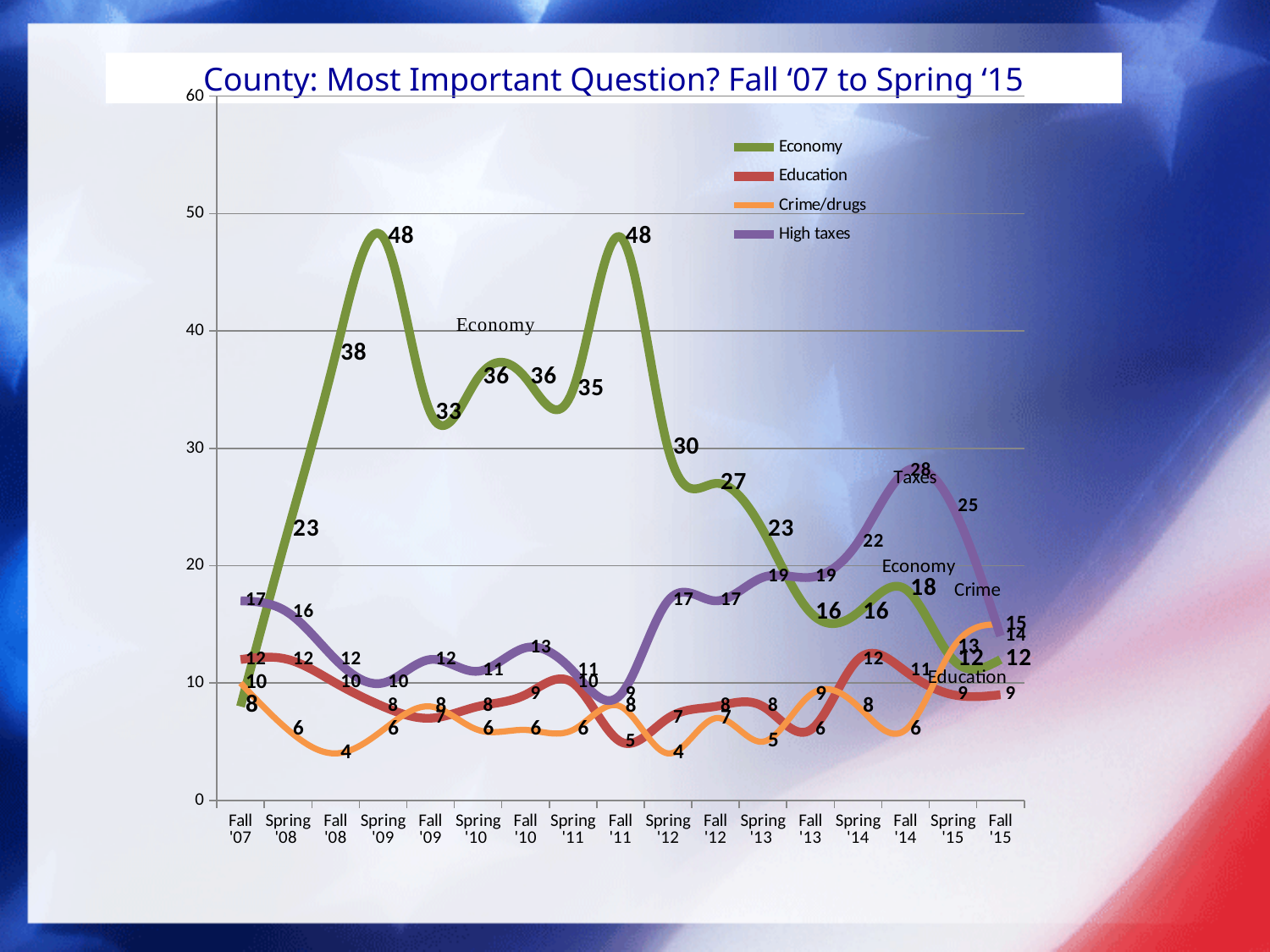
What kind of chart is shown on the slide? Line chart Does the Economy line rise or fall from Spring '12 to Fall '13? Fall Which is larger, the Economy value in Spring '09 or the Economy value in Fall '13? Spring '09 How many survey periods are shown along the x axis? 17 What is the difference between the Economy values in Spring '09 and Fall '08? 10 Is the value for High taxes in Spring '15 greater or less than 20? greater What is the highest value reached by the Economy line? 48 How many series does the legend list? 4 What is the value for Economy in Fall '08? 38 What is the value for Economy in Spring '09? 48 Which series is shown in green in the legend? Economy What is the value for High taxes in Fall '14? 28